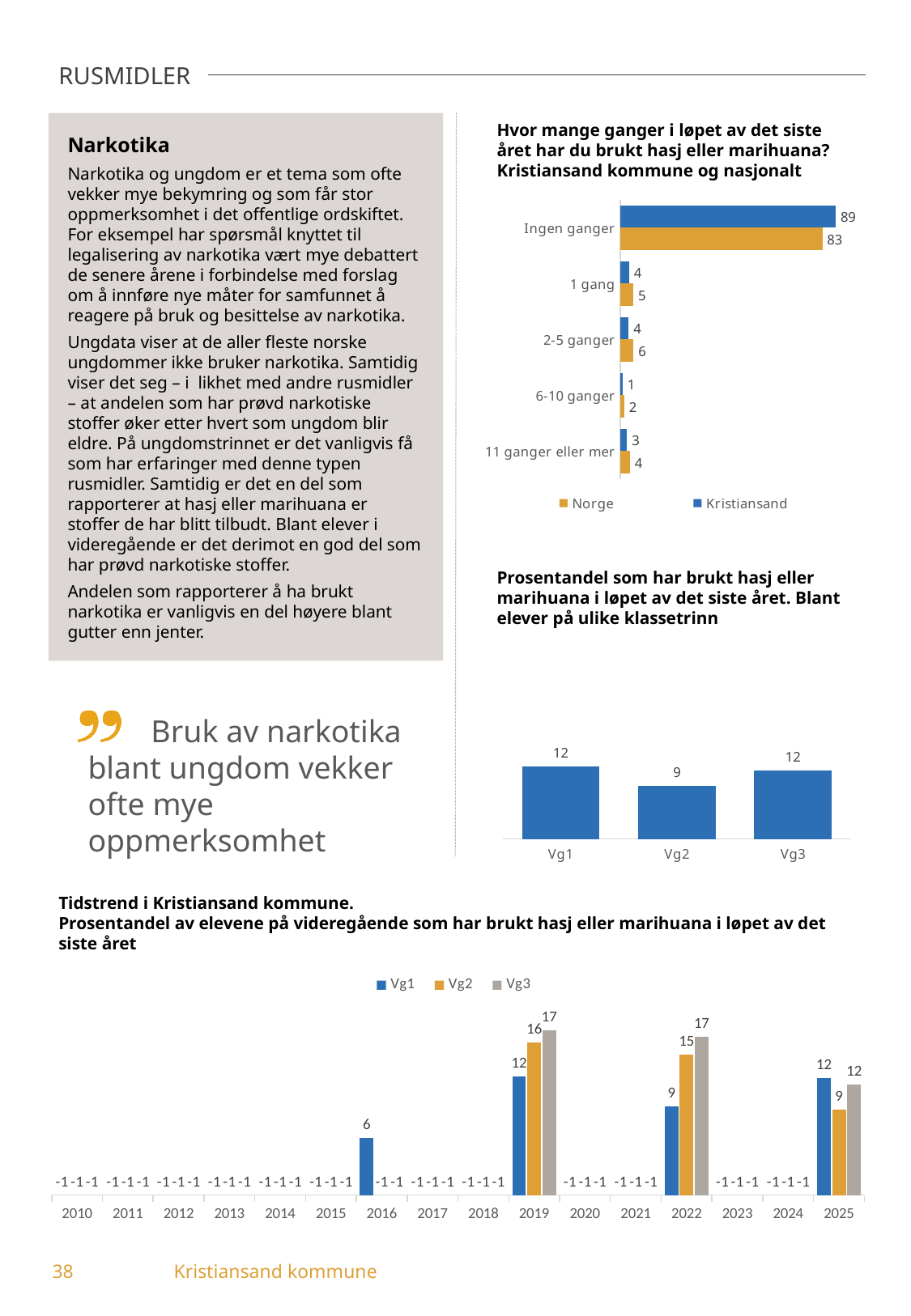
In the top-right chart 'Hvor mange ganger i løpet av det siste året har du brukt hasj eller marihuana?', what is the value for Kristiansand in the 'Ingen ganger' category? 89 In the top-right chart 'Hvor mange ganger i løpet av det siste året har du brukt hasj eller marihuana?', what is the value for Norge in the '2-5 ganger' category? 6 In the top-right chart 'Hvor mange ganger i løpet av det siste året har du brukt hasj eller marihuana?', what is the difference between the Kristiansand and Norge values for 'Ingen ganger'? 6 In the bottom chart 'Tidstrend i Kristiansand kommune', which is larger in 2022: Vg1 or Vg2? Vg2 In the middle-right chart 'Prosentandel som har brukt hasj eller marihuana i løpet av det siste året', what is the value for Vg2? 9 How many categories are shown in the middle-right chart 'Prosentandel som har brukt hasj eller marihuana i løpet av det siste året'? 3 In the bottom chart 'Tidstrend i Kristiansand kommune', what is the value for Vg3 in 2019? 17 In the middle-right chart 'Prosentandel som har brukt hasj eller marihuana i løpet av det siste året', which class level has the lowest value? Vg2 In the bottom chart 'Tidstrend i Kristiansand kommune', what is the difference between the Vg2 values for 2022 and 2025? 6 What kind of chart is the top-right chart 'Hvor mange ganger i løpet av det siste året har du brukt hasj eller marihuana?'? Bar chart In the top-right chart 'Hvor mange ganger i løpet av det siste året har du brukt hasj eller marihuana?', which category has the lowest value for Kristiansand? 6-10 ganger How many series does the legend list in the top-right chart 'Hvor mange ganger i løpet av det siste året har du brukt hasj eller marihuana?'? 2